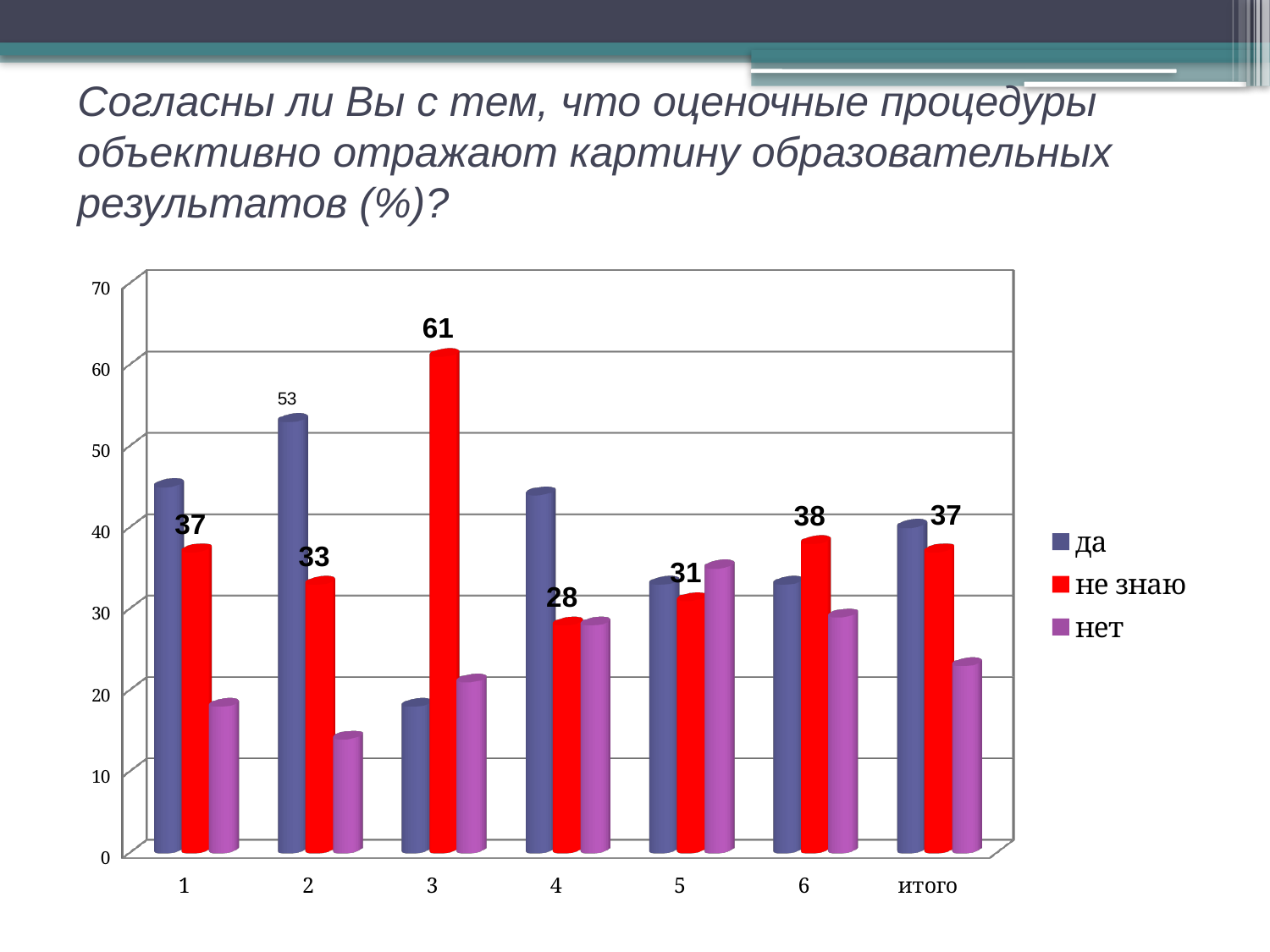
Which is larger, the "не знаю" value for category 1 or for category 2? category 1 What is the difference between the "не знаю" values for category 3 and category 4? 33 Which category has the lowest value for "не знаю"? 4 Which category has the highest value for "не знаю"? 3 What is the value for "да" in category 2? 53 How many series does the legend list? 3 Is the value for "да" in category 1 greater or less than 40? greater Is the value for "нет" in category 2 greater or less than 20? less What kind of chart is shown on the slide? bar chart How many categories are shown on the x axis? 7 What is the value for "не знаю" in category 3? 61 What is the value for "не знаю" in the "итого" category? 37